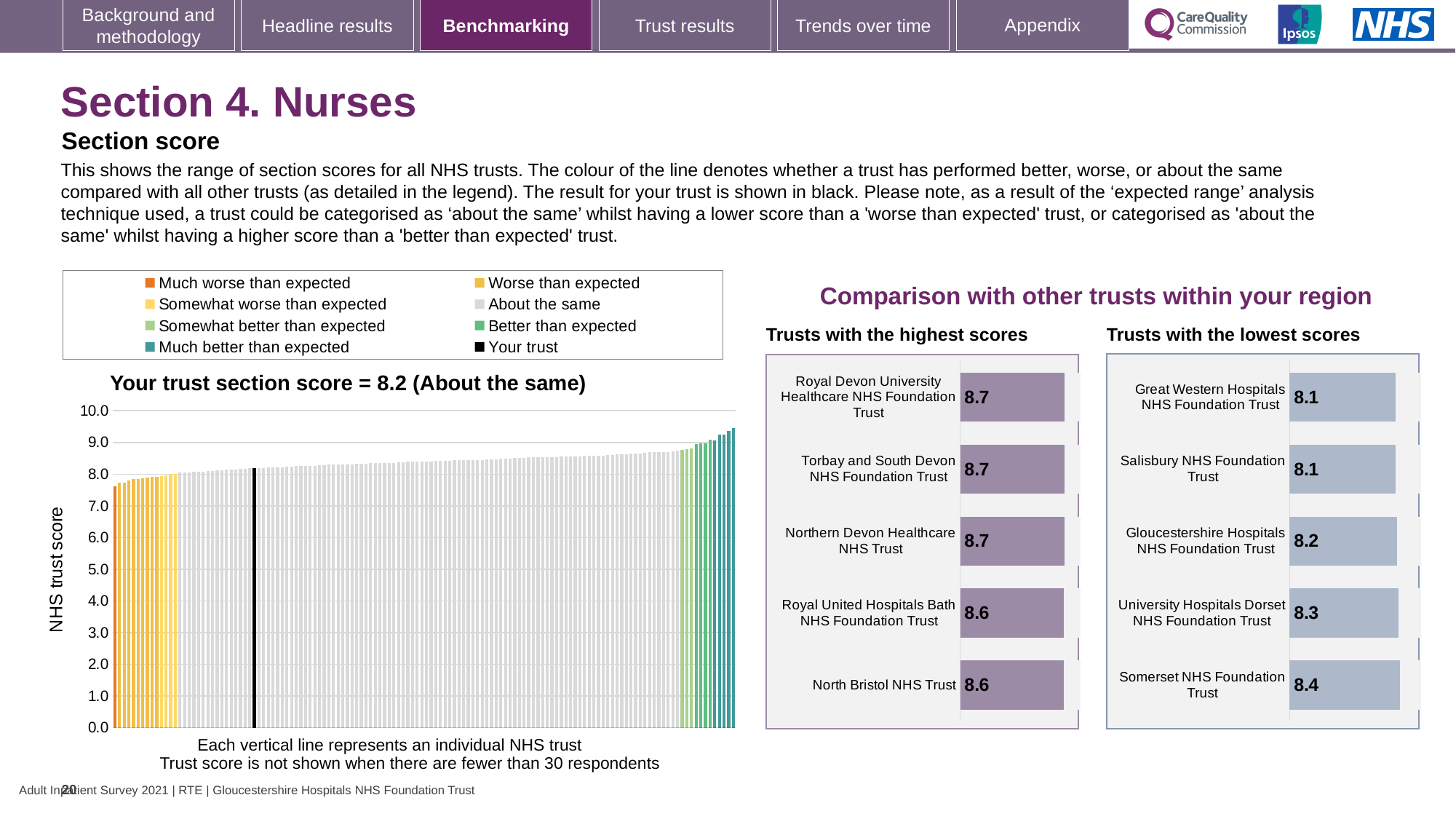
In the 'Trusts with the highest scores' chart, what is the difference between the score for Royal Devon University Healthcare NHS Foundation Trust and the score for North Bristol NHS Trust? 0.1 In the 'Your trust section score' chart, how many entries does the legend list? 8 In the 'Trusts with the lowest scores' chart, what is the score for Gloucestershire Hospitals NHS Foundation Trust? 8.2 In the 'Your trust section score' chart, what is the section score for your trust? 8.2 In the 'Your trust section score' chart, what kind of chart is shown? bar chart In the 'Your trust section score' chart, is the value of the highest bar greater or less than 9.0? greater In the 'Your trust section score' chart, what is the label on the vertical axis? NHS trust score In the 'Trusts with the lowest scores' chart, which trust has the highest score? Somerset NHS Foundation Trust In the 'Your trust section score' chart, is the value of the lowest bar greater or less than 8.0? less In the 'Trusts with the highest scores' chart, what is the score for North Bristol NHS Trust? 8.6 In the 'Trusts with the highest scores' chart, how many trusts are shown? 5 In the 'Trusts with the lowest scores' chart, which has the larger score: Somerset NHS Foundation Trust or Great Western Hospitals NHS Foundation Trust? Somerset NHS Foundation Trust